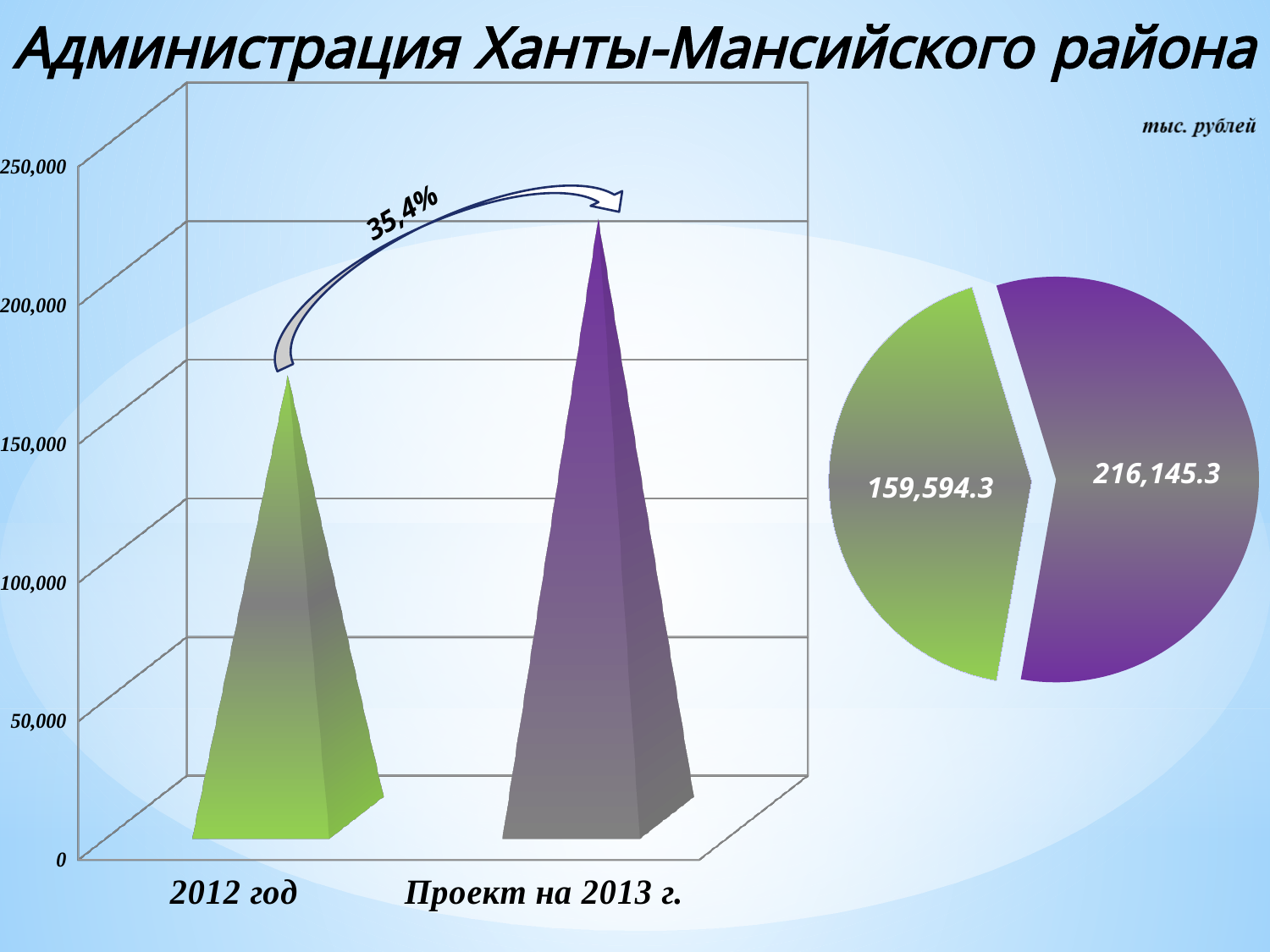
In the bar chart on the left, which category has the highest value? Проект на 2013 г. In the bar chart on the left, which is larger: the value for 2012 год or for Проект на 2013 г.? Проект на 2013 г. What kind of chart is shown on the left side of the slide? bar chart In the bar chart on the left, is the value for Проект на 2013 г. greater or less than 200,000? greater In the bar chart on the left, how many categories are shown on the x axis? 2 What percentage is written on the arrow between the two bars in the bar chart? 35,4% In the pie chart on the right, what value is printed on the purple slice? 216,145.3 In the bar chart on the left, is the value for 2012 год greater or less than 100,000? greater In the pie chart on the right, what is the difference between the purple slice value and the green slice value? 56,551.0 In the pie chart on the right, what value is printed on the green slice? 159,594.3 In the bar chart on the left, which category has the lowest value? 2012 год What kind of chart is shown on the right side of the slide? pie chart